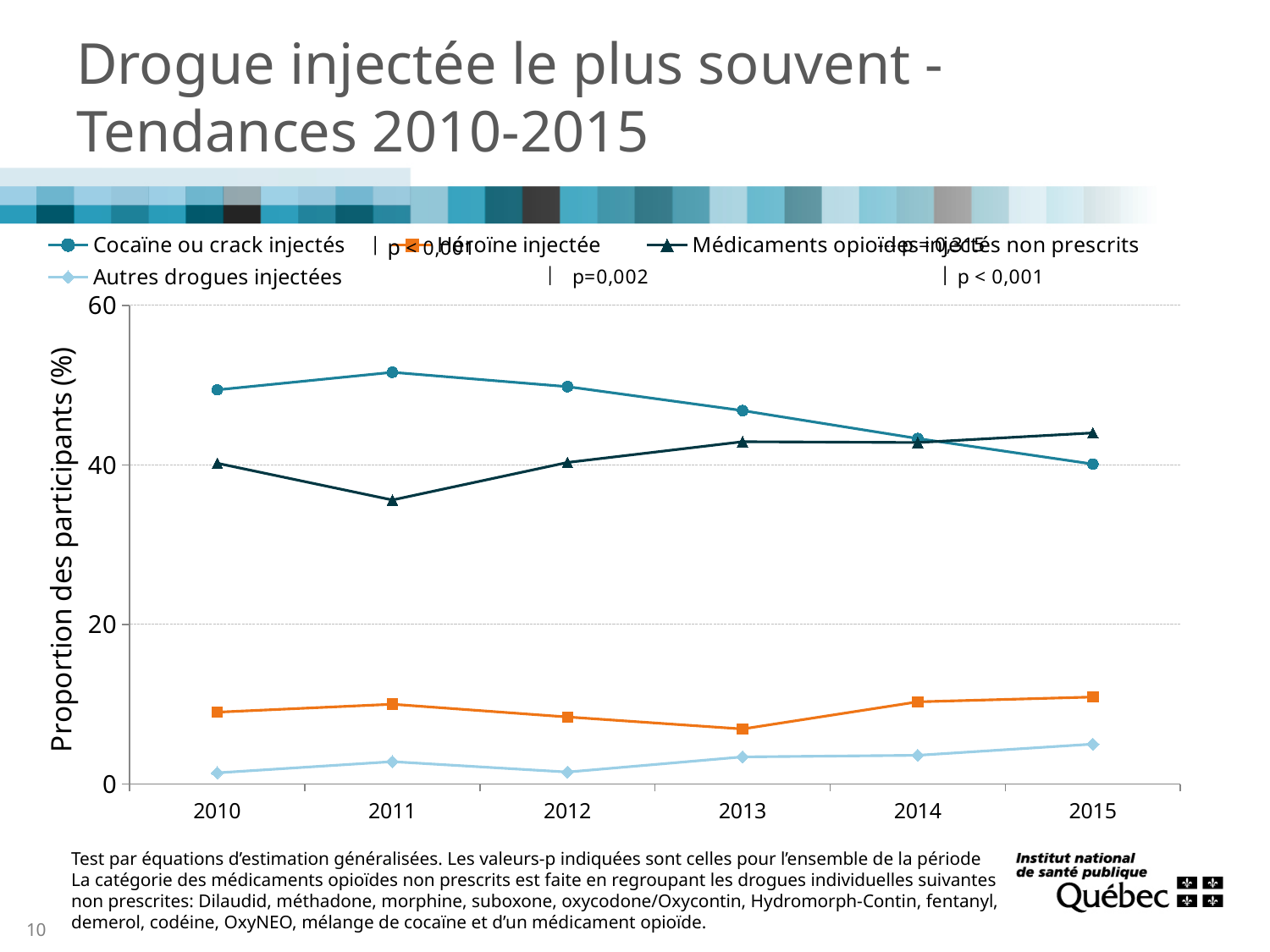
Does the value for Cocaïne ou crack injectés rise or fall from 2011 to 2015? Fall What is the title of the slide? Drogue injectée le plus souvent - Tendances 2010-2015 How many series does the legend list? 4 How many years are plotted along the x axis? 6 Is the value for Cocaïne ou crack injectés in 2011 greater or less than 40? greater In 2015, which is larger: Cocaïne ou crack injectés or Médicaments opioïdes injectés non prescrits? Médicaments opioïdes injectés non prescrits In which year is the value for Médicaments opioïdes injectés non prescrits lowest? 2011 What kind of chart is shown on the slide? Line chart Is the value for Médicaments opioïdes injectés non prescrits in 2011 greater or less than 40? less In which year is the value for Cocaïne ou crack injectés highest? 2011 Is the value for Héroïne injectée in 2015 greater or less than 20? less What is the label of the y axis? Proportion des participants (%)